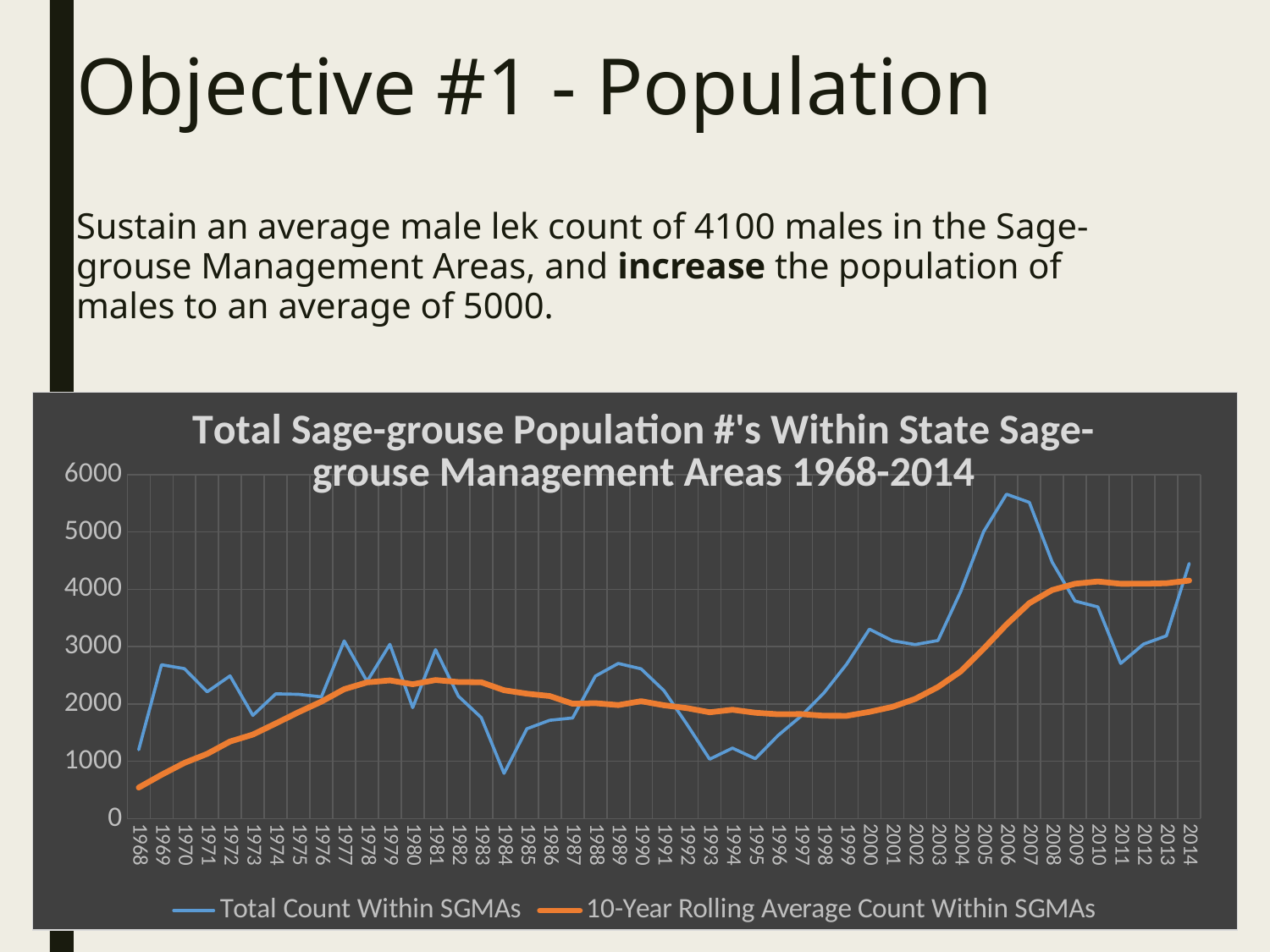
Is the 10-Year Rolling Average Count Within SGMAs for 1979 greater or less than 2000? greater Is the Total Count Within SGMAs for 1993 greater or less than 2000? less Does the 10-Year Rolling Average Count Within SGMAs rise or fall from 1968 to 1979? rise Which is larger, the Total Count Within SGMAs in 2006 or in 1977? 2006 How many years are plotted along the x axis of the chart? 47 How many series does the chart legend list? 2 Is the 10-Year Rolling Average Count Within SGMAs for 1968 greater or less than 1000? less In which year does the Total Count Within SGMAs reach its highest value? 2006 What is the title of the chart? Total Sage-grouse Population #'s Within State Sage-grouse Management Areas 1968-2014 What kind of chart is shown on the slide? line chart In which year does the Total Count Within SGMAs reach its lowest value? 1984